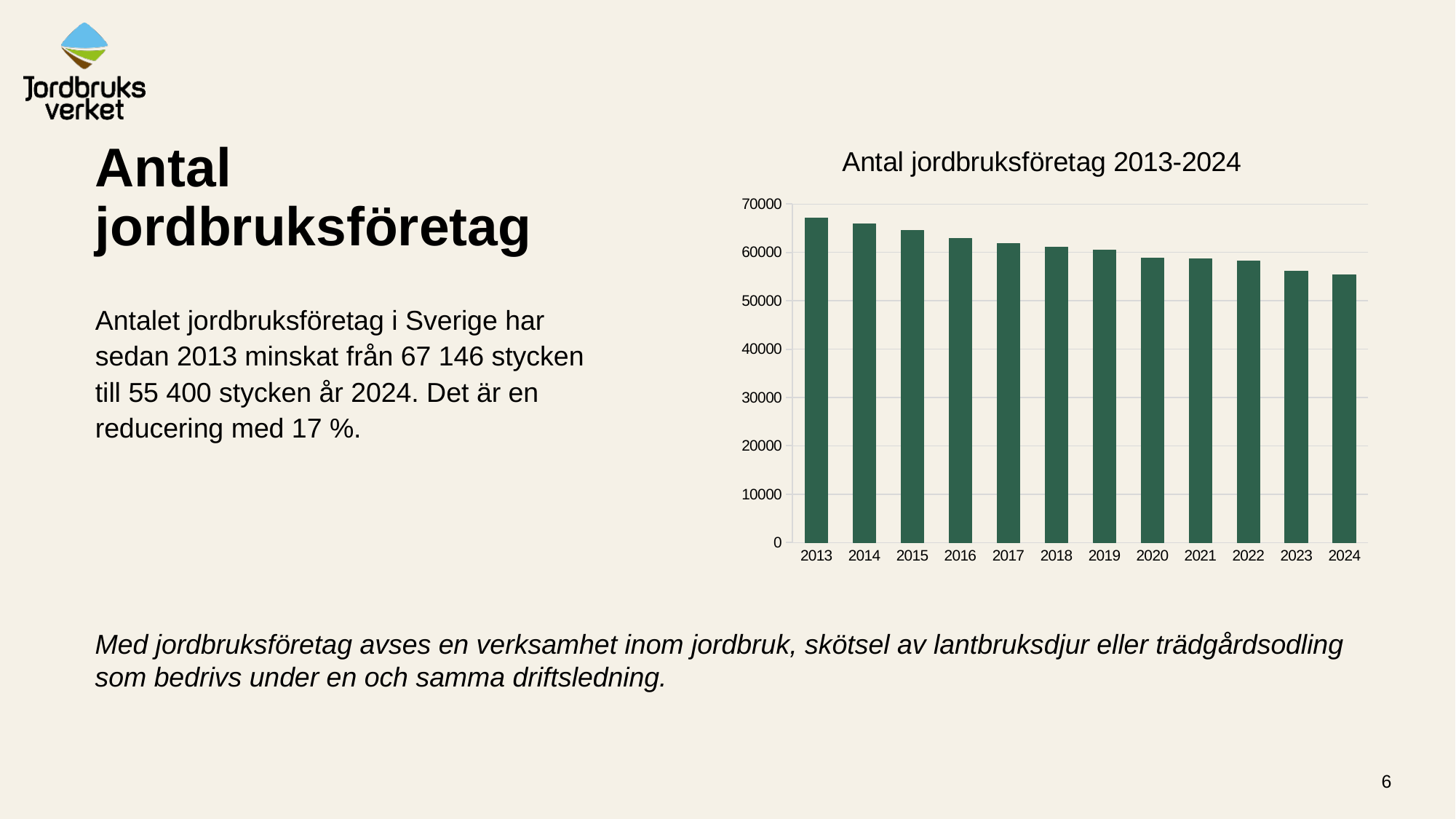
Is the value for 2022 greater or less than 60000? less What type of chart is shown on the slide? Bar chart According to the slide, how many jordbruksföretag were there in 2024? 55 400 What is the title of the chart? Antal jordbruksföretag 2013-2024 How many years (bars) are shown in the chart? 12 Is the value for 2015 greater or less than 60000? greater Is the value for 2024 greater or less than 60000? less Which year has the lowest number of jordbruksföretag? 2024 Which year has the highest number of jordbruksföretag? 2013 Do the values rise or fall from 2013 to 2024? Fall Which year has a larger value, 2014 or 2022? 2014